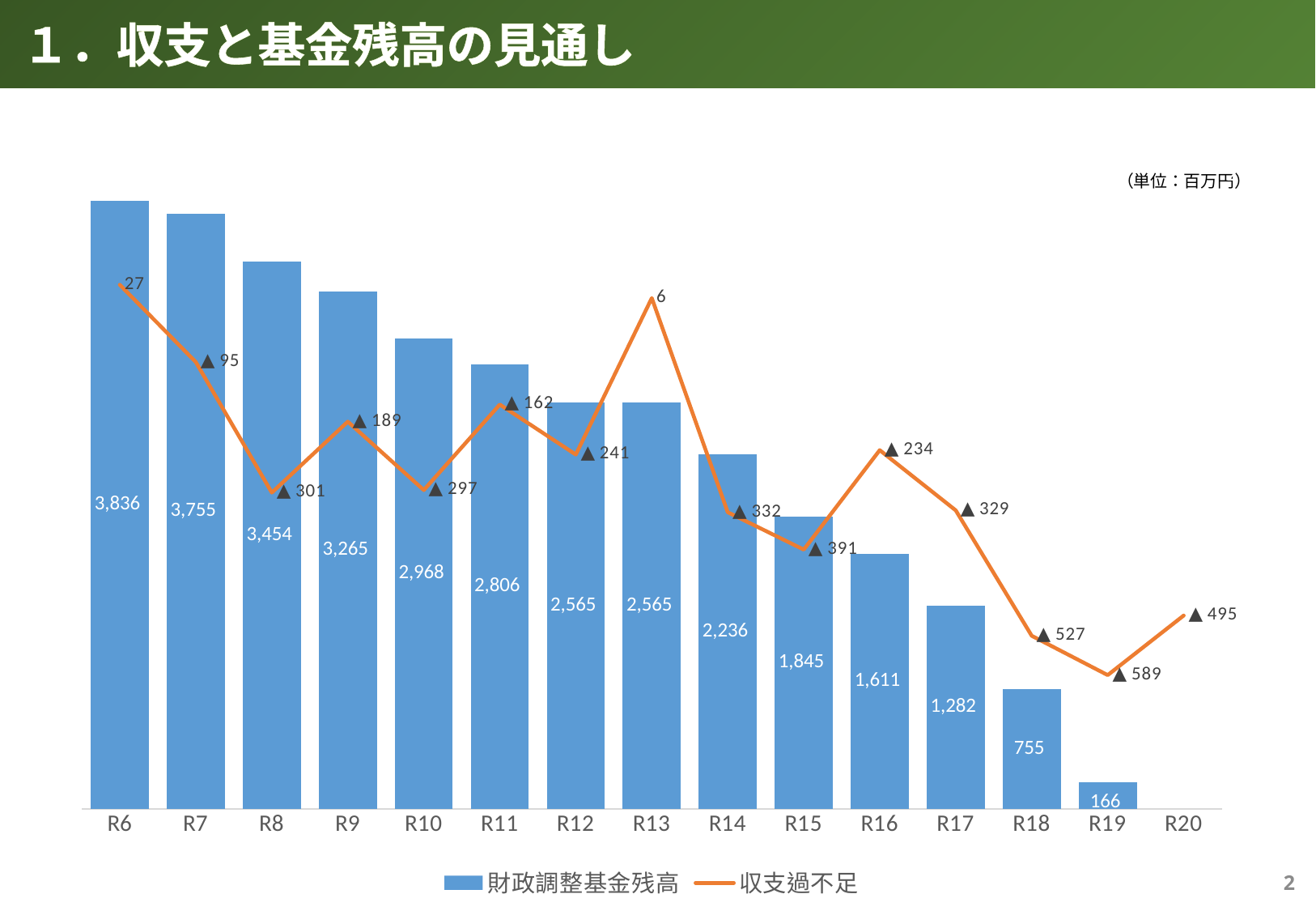
How many series does the legend list? 2 What is the value of 収支過不足 for R13? 6 Do the 財政調整基金残高 bars rise or fall from R6 to R19? Fall Which is larger, the 財政調整基金残高 for R14 or for R16? R14 What is the value of 財政調整基金残高 for R6? 3,836 What is the difference in 財政調整基金残高 between R6 and R7? 81 Which year has the lowest 財政調整基金残高 bar with a printed value? R19 How many years are shown on the x axis? 15 Which year has the highest 財政調整基金残高? R6 What is the value of 財政調整基金残高 for R17? 1,282 What kind of chart is this? Combined bar and line chart What is the value of 収支過不足 for R19? ▲ 589